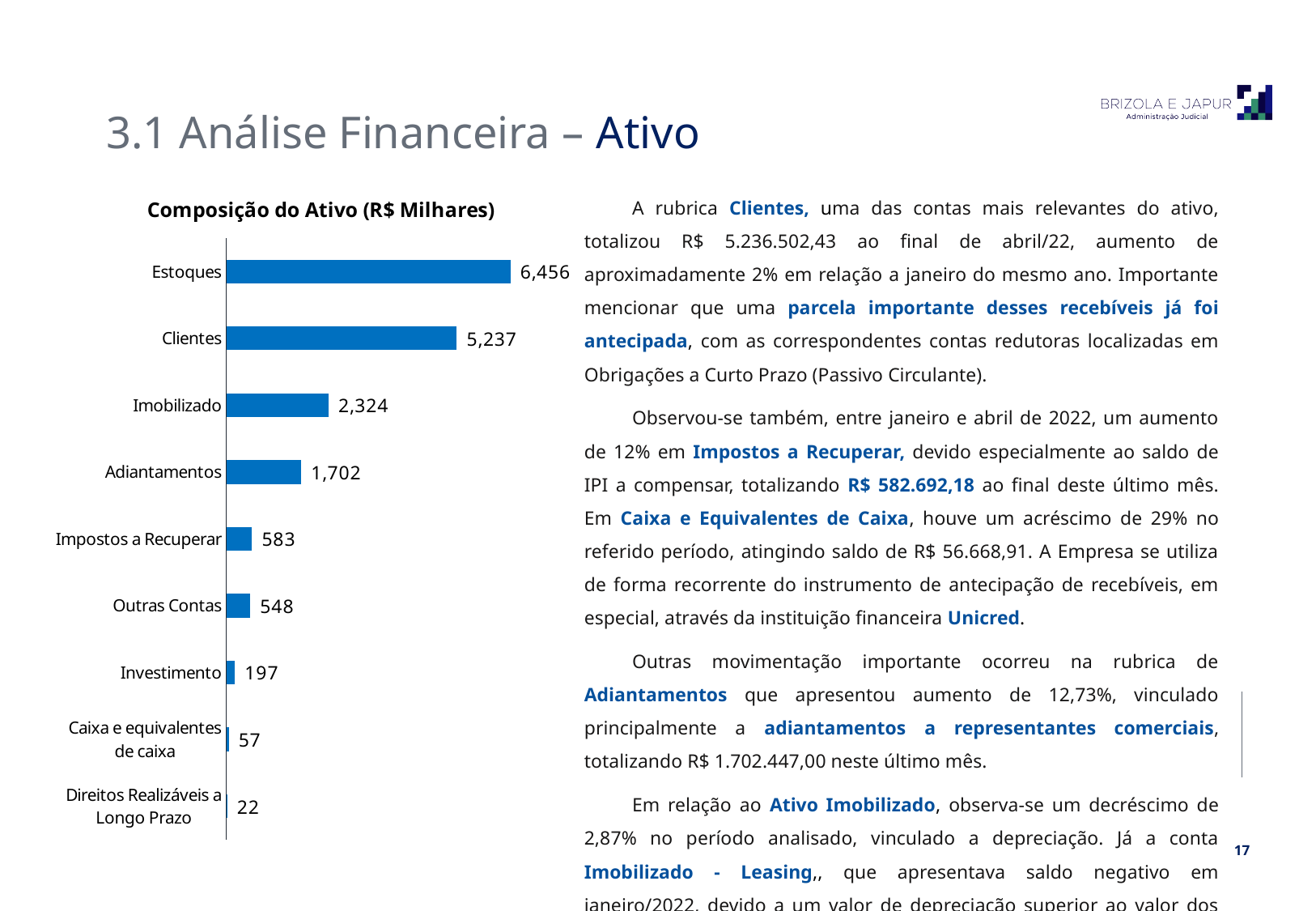
What is the value for Adiantamentos in the chart? 1,702 What kind of chart is shown on the slide? Bar chart Which is larger, the value for Imobilizado or the value for Adiantamentos? Imobilizado How many categories are shown in the chart? 9 What is the title of the chart? Composição do Ativo (R$ Milhares) What is the value for Clientes in the chart? 5,237 What is the value for Estoques in the chart? 6,456 What is the difference between the values for Impostos a Recuperar and Outras Contas? 35 Which category has the lowest value in the chart? Direitos Realizáveis a Longo Prazo What is the value for Impostos a Recuperar in the chart? 583 What is the difference between the values for Estoques and Clientes? 1,219 Which category has the highest value in the chart? Estoques